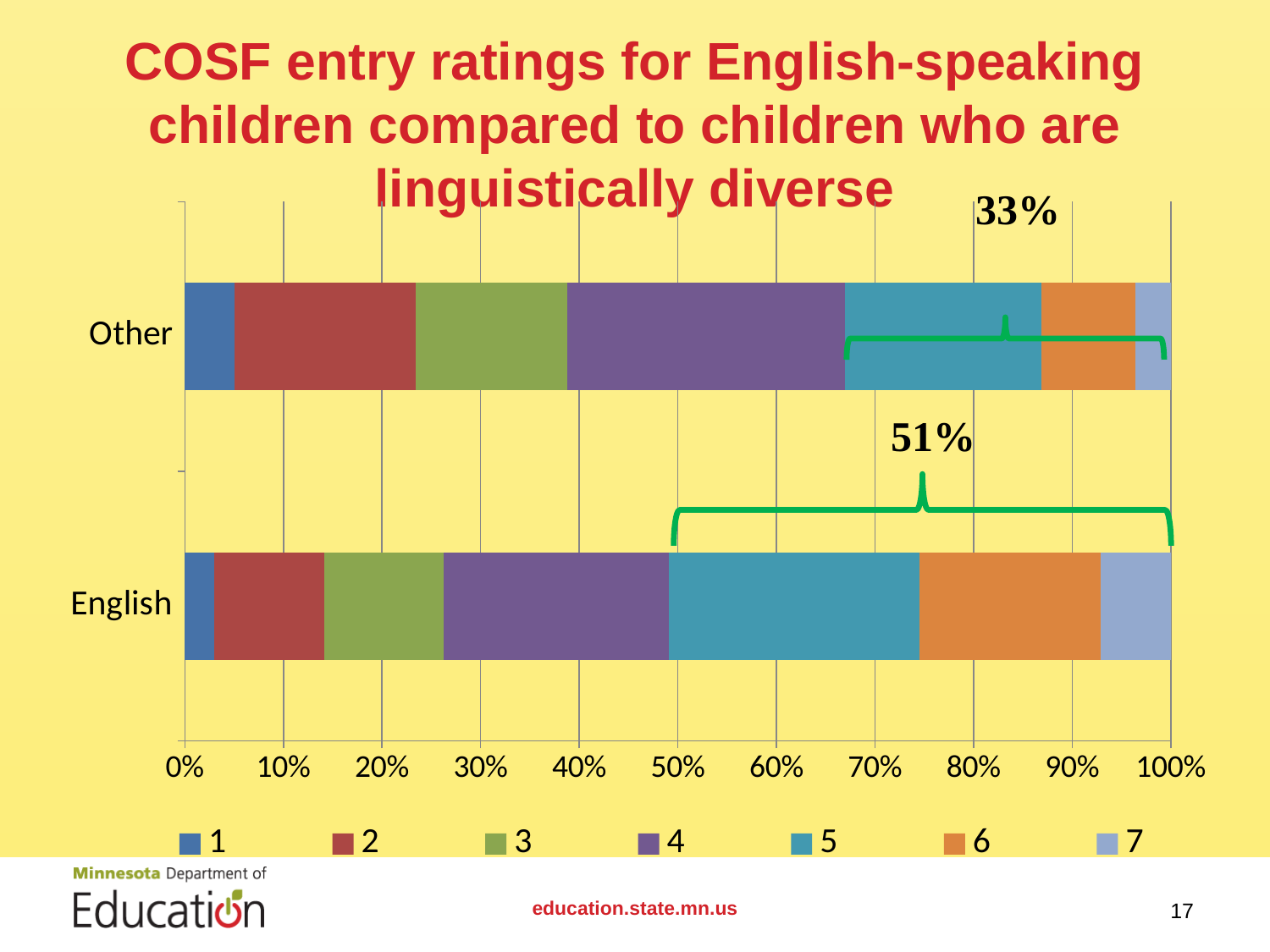
Is the width of the rating 7 segment in the English bar greater or less than 10%? less What percentage is annotated above the bracket on the English bar? 51% How many series does the legend list? 7 What is the highest value shown on the horizontal axis? 100% Which group has the larger annotated bracketed percentage, English or Other? English In the Other bar, does the boundary between rating 4 and rating 5 fall at a value greater or less than 60%? greater How many groups (bars) are plotted on the chart? 2 In the English bar, which rating has the narrowest segment? 1 In the Other bar, which rating has the widest segment? 4 What percentage is annotated above the bracket on the Other bar? 33% What is the difference between the annotated percentage for English (51%) and for Other (33%)? 18% What kind of chart is shown on the slide? Stacked bar chart